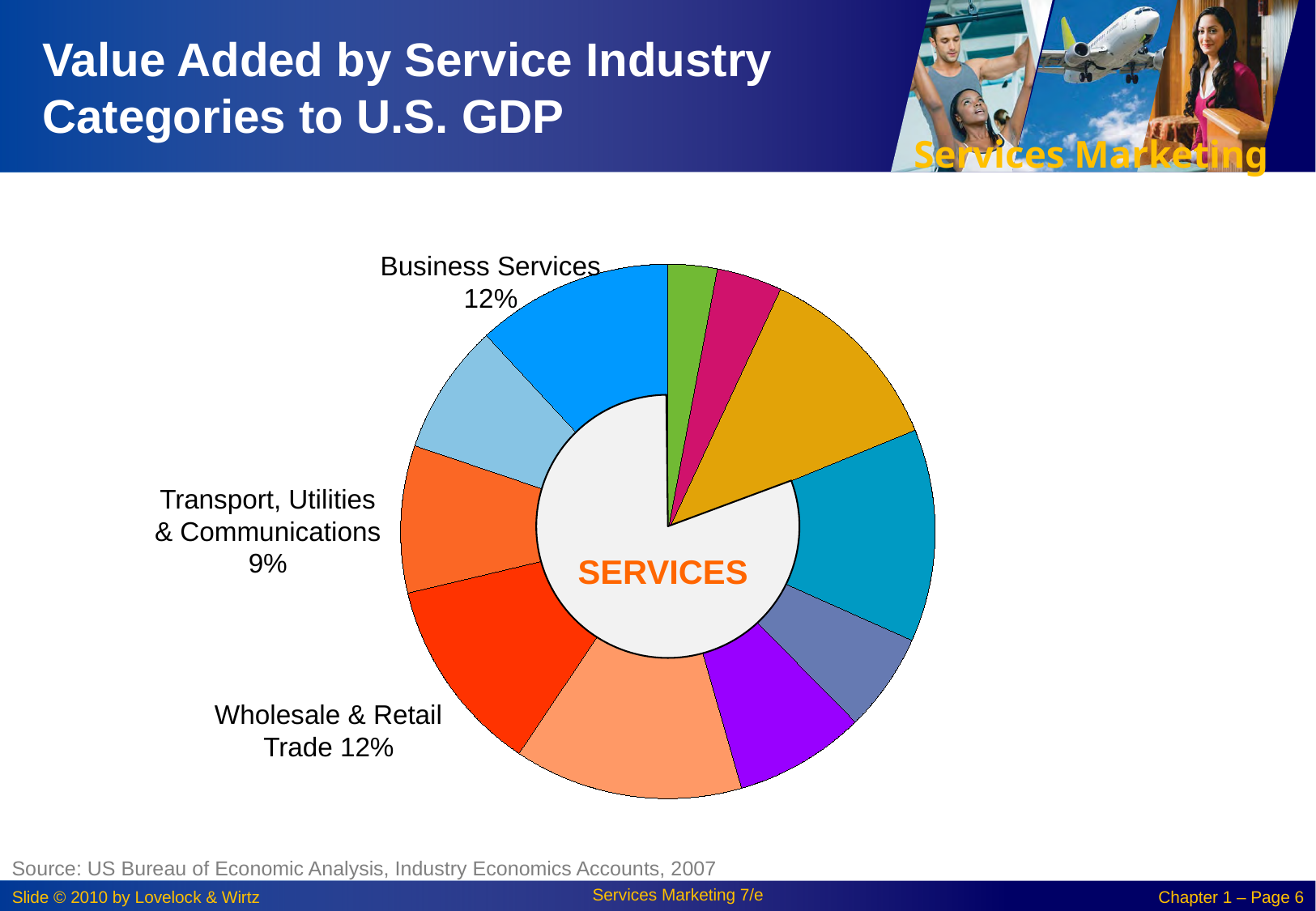
What share of U.S. GDP value added is attributed to Business Services in the pie chart? 12% Which is larger, the share for Business Services or the share for Transport, Utilities & Communications? Business Services Is the share for Business Services equal to the share for Wholesale & Retail Trade? Yes What percentage is shown for Transport, Utilities & Communications? 9% What type of chart is shown on the slide? Pie chart What is the combined share of the three labeled categories (Business Services, Transport, Utilities & Communications, and Wholesale & Retail Trade)? 33% Of the three labeled categories, which has the smallest share? Transport, Utilities & Communications What word is printed in the center of the pie chart? SERVICES What is the title of the slide containing the chart? Value Added by Service Industry Categories to U.S. GDP What percentage is labeled for Wholesale & Retail Trade? 12% By how many percentage points does Wholesale & Retail Trade exceed Transport, Utilities & Communications? 3% How many slices does the pie chart contain? 11